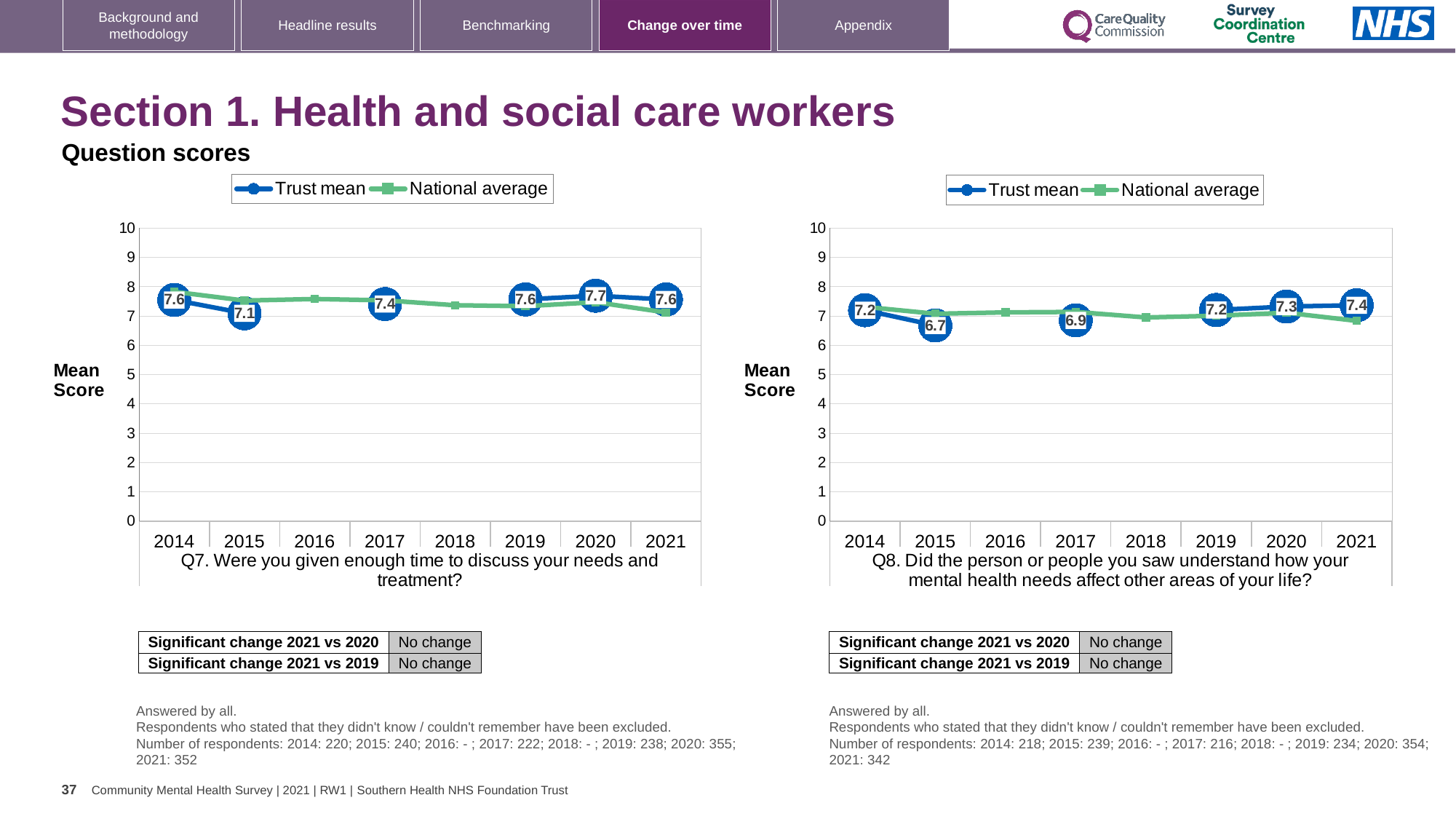
In the Q7 chart (left), what is the difference between the Trust mean in 2020 and in 2015? 0.6 How many series does the legend of the Q7 chart (left) list? 2 In the Q8 chart (right), is the National average for 2021 greater or less than 8? less In the Q8 chart (right), what is the Trust mean for 2015? 6.7 In the Q8 chart (right), which year has the lowest labelled Trust mean? 2015 In the Q8 chart (right), is the Trust mean for 2017 larger or smaller than the Trust mean for 2020? smaller What type of chart is the Q7 chart (left)? Line chart In the Q7 chart (left), which year has the highest labelled Trust mean? 2020 How many years are shown on the x axis of the Q8 chart (right)? 8 In the Q7 chart (left), what is the Trust mean for 2021? 7.6 In the Q8 chart (right), what is the Trust mean for 2021? 7.4 In the Q7 chart (left), what is the Trust mean for 2015? 7.1